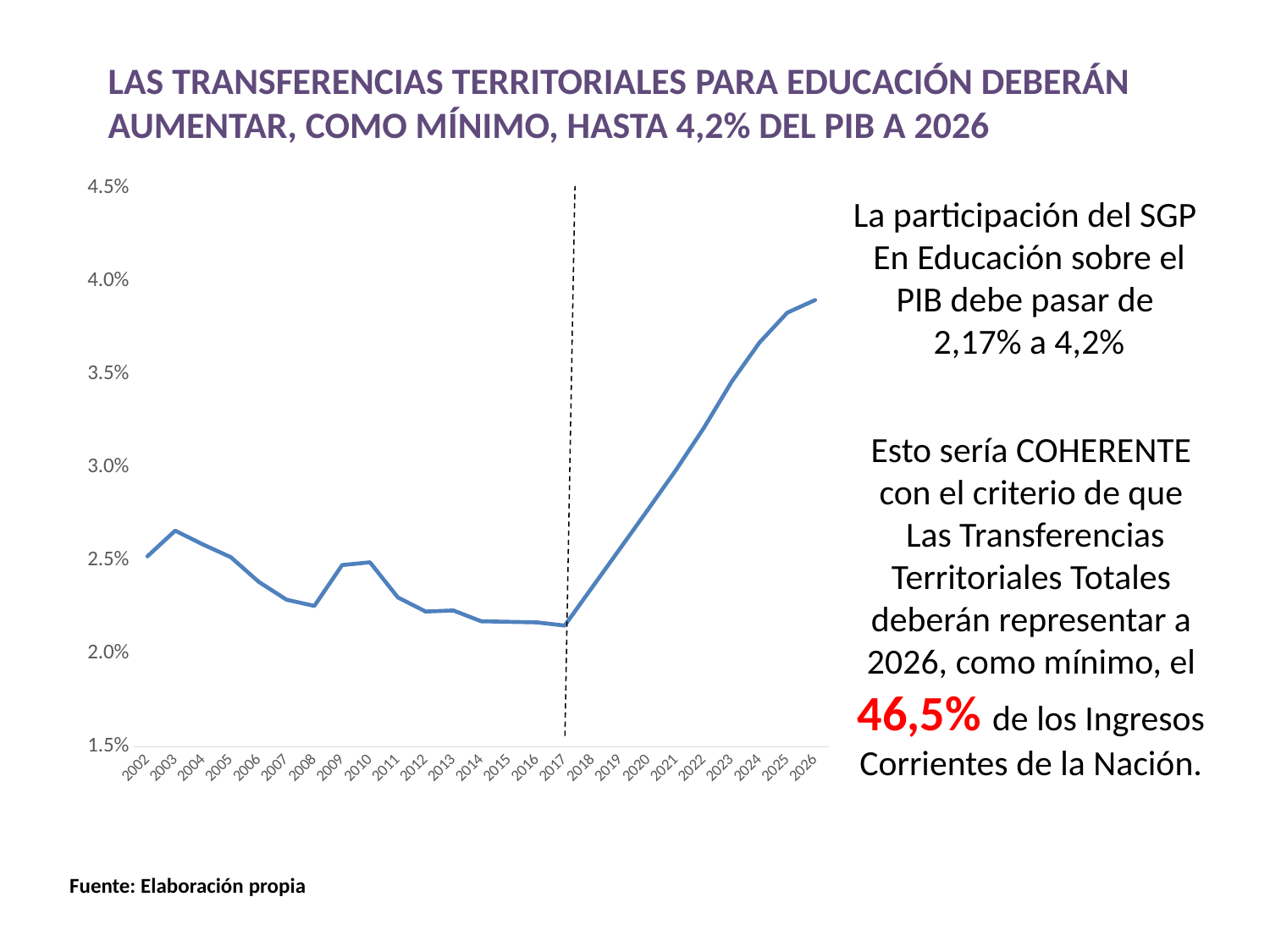
Is the value for 2026 greater or less than 3.5%? greater Is the value for 2012 greater or less than 2.5%? less At which year is the dashed vertical line placed on the chart? 2017 Which year has the highest value on the chart? 2026 Which is larger, the value for 2003 or the value for 2008? 2003 Is the value for 2022 greater or less than 3.0%? greater Do the values rise or fall from 2017 to 2026? rise Which is larger, the value for 2002 or the value for 2026? 2026 How many years are plotted along the x axis of the chart? 25 What kind of chart is shown on the slide? line chart